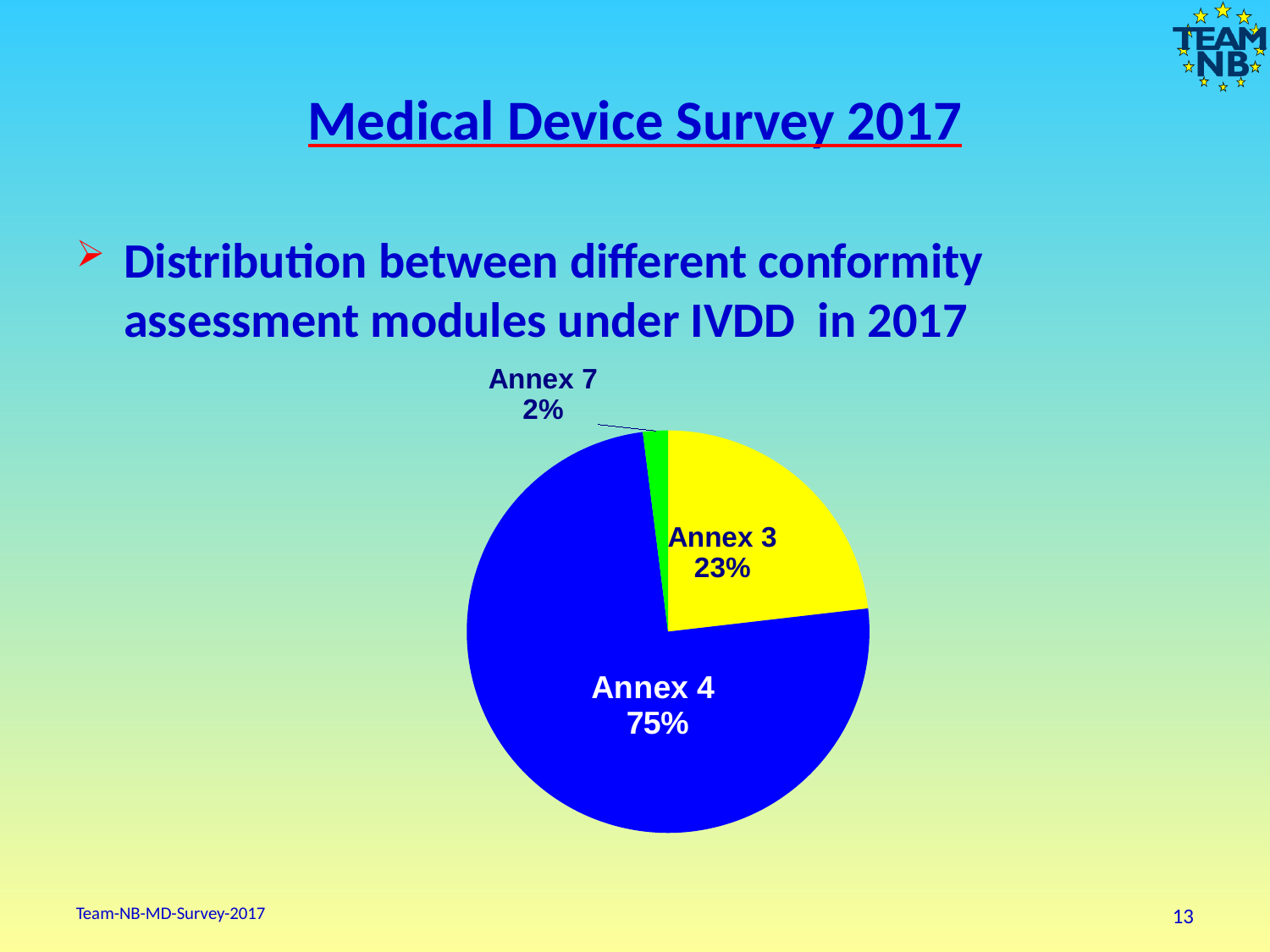
Which is larger, the share for Annex 3 or the share for Annex 7? Annex 3 What kind of chart is shown on the slide? pie chart What is the difference in percentage points between Annex 4 and Annex 3? 52 What colour is the Annex 4 slice? blue What is the difference in percentage points between Annex 3 and Annex 7? 21 Which annex has the smallest slice of the pie? Annex 7 What share of the pie does Annex 7 represent? 2% What colour is the Annex 3 slice? yellow How many slices does the pie chart have? 3 What share of the pie does Annex 3 represent? 23% Which annex has the largest slice of the pie? Annex 4 What share of the pie does Annex 4 represent? 75%